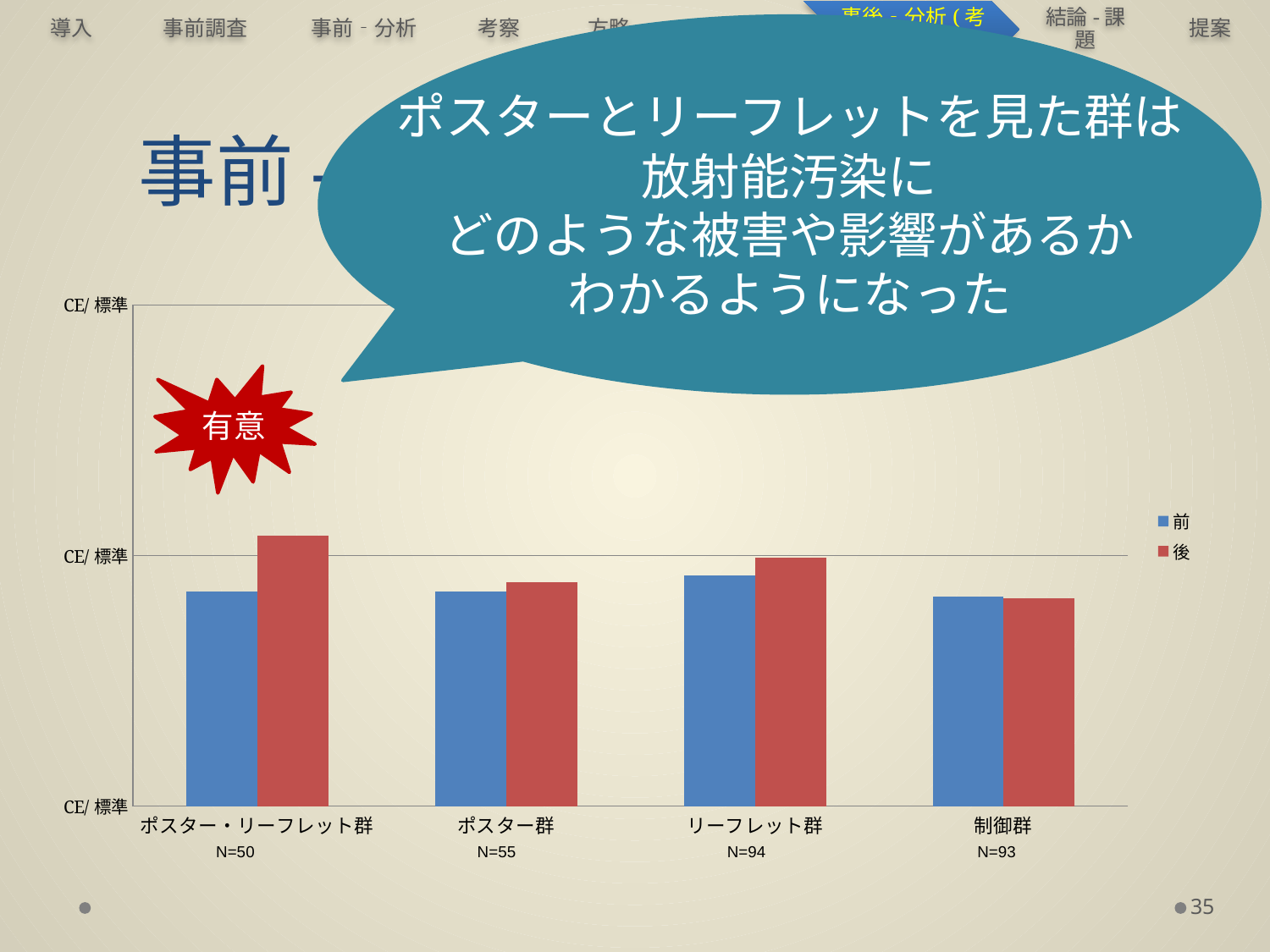
Which colour represents the 後 series in the chart? red How many series does the chart legend list? 2 Which group has the highest 前 (blue) bar? リーフレット群 For ポスター・リーフレット群, which is larger, the 前 bar or the 後 bar? 後 Which group has the lowest 後 (red) bar? 制御群 What are the two series named in the chart legend? 前 and 後 What sample size is shown under the 制御群 category? N=93 How many groups (categories) are shown on the x axis of the chart? 4 Which group has the highest 後 (red) bar? ポスター・リーフレット群 For リーフレット群, which is larger, the 前 bar or the 後 bar? 後 What kind of chart is shown on the slide? bar chart What sample size is shown under the ポスター・リーフレット群 category? N=50